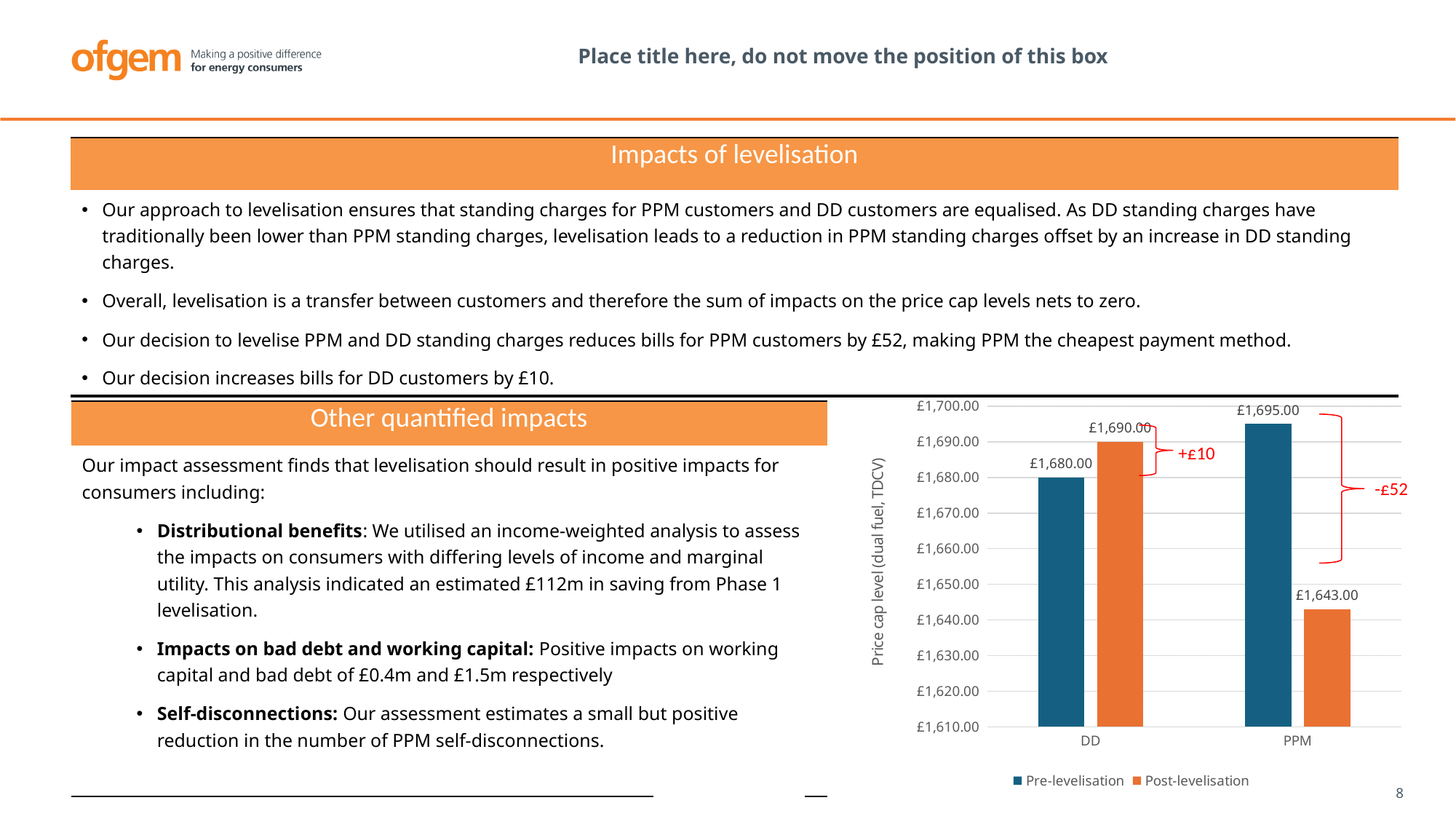
What is the difference between the Post-levelisation and Pre-levelisation values for DD? £10.00 What type of chart is shown on the slide? Bar chart What is the Post-levelisation price cap level for DD? £1,690.00 Which bar shows the highest price cap level? PPM Pre-levelisation What is the Pre-levelisation price cap level for PPM? £1,695.00 Which bar shows the lowest price cap level? PPM Post-levelisation What is the Post-levelisation price cap level for PPM? £1,643.00 What is the Pre-levelisation price cap level for DD? £1,680.00 How many categories are shown on the x axis of the chart? 2 What is the difference between the Pre-levelisation and Post-levelisation values for PPM? £52.00 How many series does the chart legend list? 2 Which is larger, the Post-levelisation value for DD or the Post-levelisation value for PPM? DD